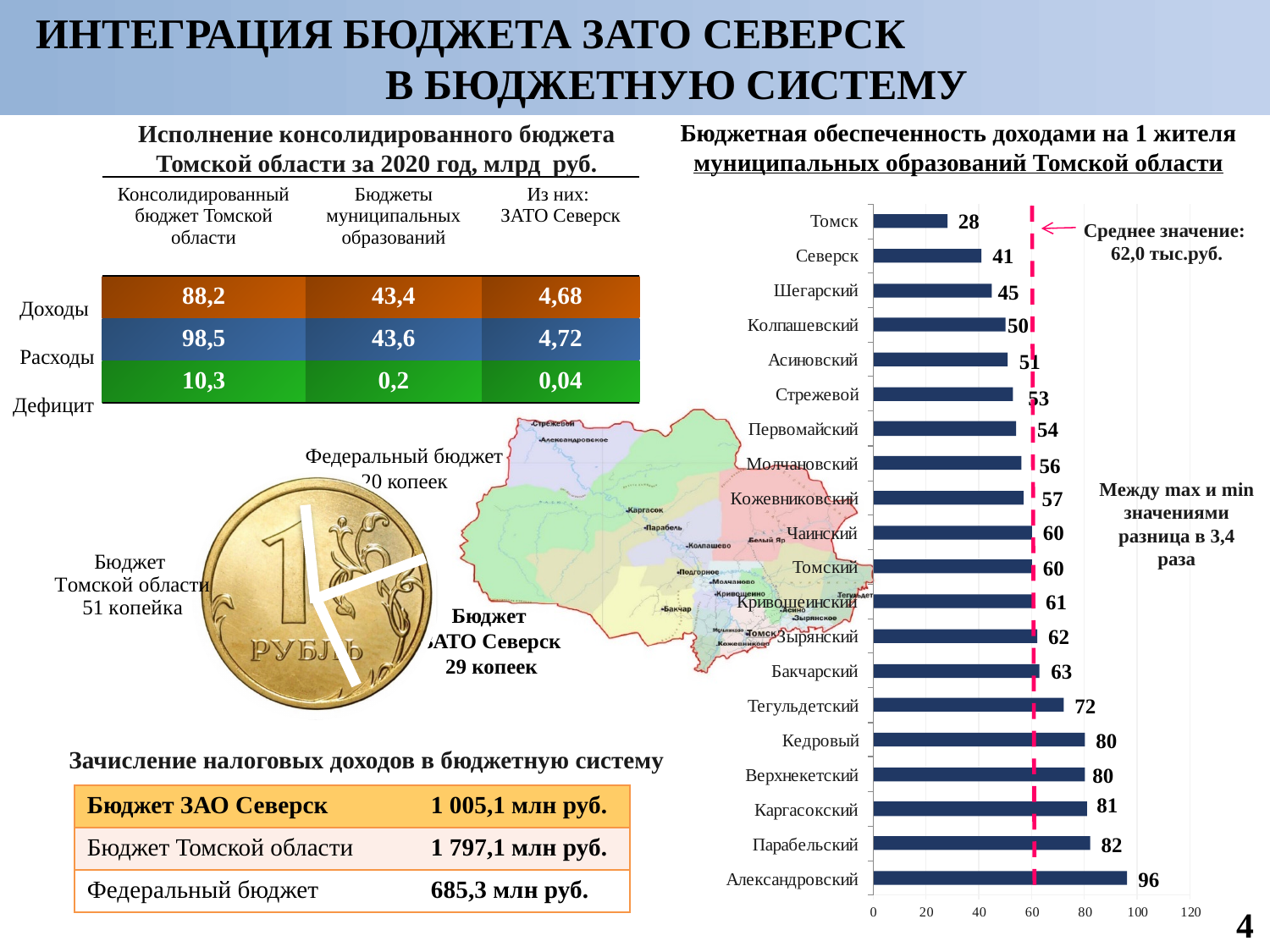
What type of chart is used to show 'Бюджетная обеспеченность доходами на 1 жителя'? bar chart Which municipality has the lowest value in the bar chart? Томск What is the difference between the values for Каргасокский and Северск in the bar chart? 40 What is the value for Колпашевский in the bar chart? 50 What is the value for Тегульдетский in the bar chart? 72 What average value is marked by the dashed line in the bar chart? 62,0 тыс.руб. How many municipalities are shown in the bar chart? 20 What is the value for Северск in the chart 'Бюджетная обеспеченность доходами на 1 жителя муниципальных образований Томской области'? 41 Which has a larger value in the bar chart, Парабельский or Кедровый? Парабельский What is the difference between the values for Александровский and Томск in the bar chart? 68 Is the value for Шегарский in the bar chart greater or less than 60? less Which municipality has the highest value in the bar chart? Александровский